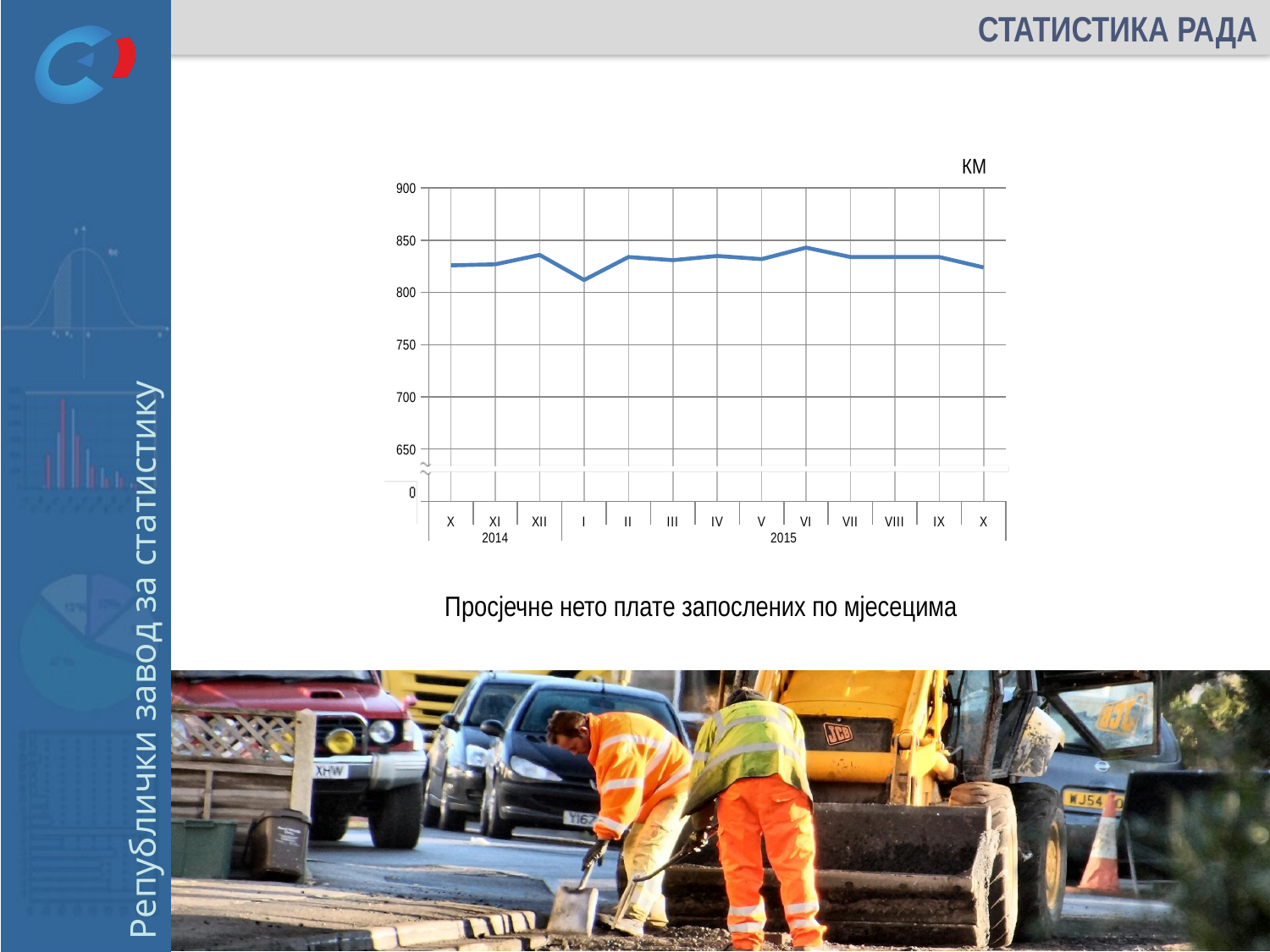
Which is larger, the value for XII 2014 or the value for I 2015? XII 2014 Is the value for I 2015 greater or less than 850? less What is the caption written below the chart? Просјечне нето плате запослених по мјесецима What kind of chart is shown on the slide? line chart Is the value for I 2015 greater or less than 800? greater Does the line rise or fall from IX 2015 to X 2015? fall Is the value for VI 2015 greater or less than 800? greater What unit is shown above the y axis of the chart? KM How many monthly data points are plotted on the chart? 13 Which month has the lowest average net wage on the chart? I 2015 Which is larger, the value for I 2015 or the value for VI 2015? VI 2015